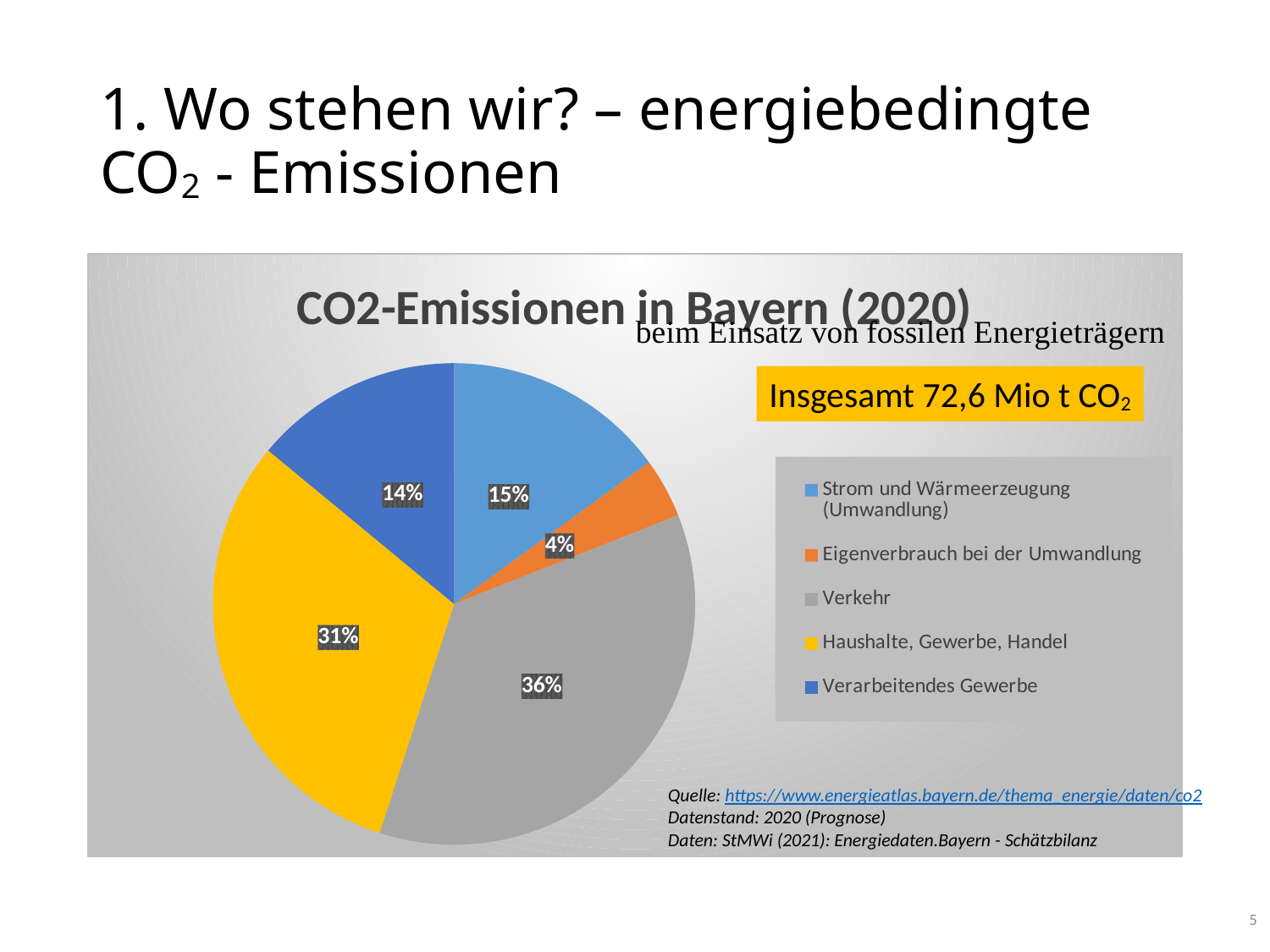
What share of the pie does Eigenverbrauch bei der Umwandlung account for? 4% What kind of chart is shown on the slide? pie chart What share of the pie does Verarbeitendes Gewerbe account for? 14% What is the difference in percentage points between Verkehr and Haushalte, Gewerbe, Handel? 5% Which category has the largest slice of the pie? Verkehr What is the title of the chart? CO2-Emissionen in Bayern (2020) Which category has the smallest slice of the pie? Eigenverbrauch bei der Umwandlung Which is larger, the share for Verkehr or the share for Haushalte, Gewerbe, Handel? Verkehr What share of the pie does Strom und Wärmeerzeugung (Umwandlung) account for? 15% How many categories does the legend list? 5